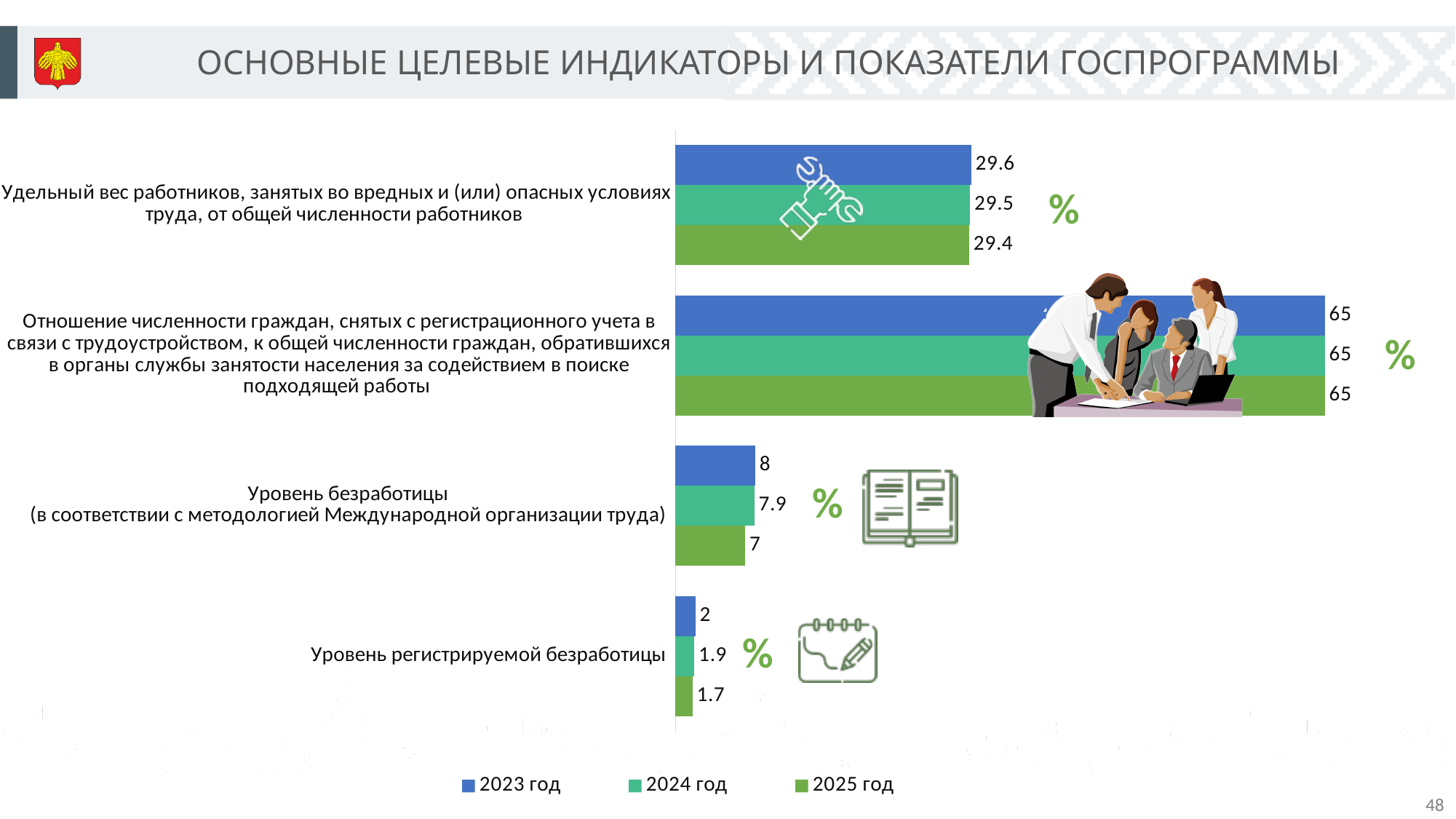
What is the value for 2025 год for "Отношение численности граждан, снятых с регистрационного учета в связи с трудоустройством..."? 65 What is the value for 2024 год for "Удельный вес работников, занятых во вредных и (или) опасных условиях труда, от общей численности работников"? 29.5 How many categories (indicators) are plotted in the chart? 4 What is the difference between the 2023 год and 2025 год values for "Уровень безработицы"? 1 Do the values for "Удельный вес работников, занятых во вредных и (или) опасных условиях труда" rise or fall from 2023 год to 2025 год? fall What is the value for 2025 год for "Уровень регистрируемой безработицы"? 1.7 Which is larger for "Уровень регистрируемой безработицы": the 2023 год value or the 2024 год value? 2023 год What is the value for 2023 год for "Уровень безработицы (в соответствии с методологией Международной организации труда)"? 8 How many series does the legend list? 3 Which category has the lowest value for 2025 год? Уровень регистрируемой безработицы What kind of chart is shown on the slide? bar chart